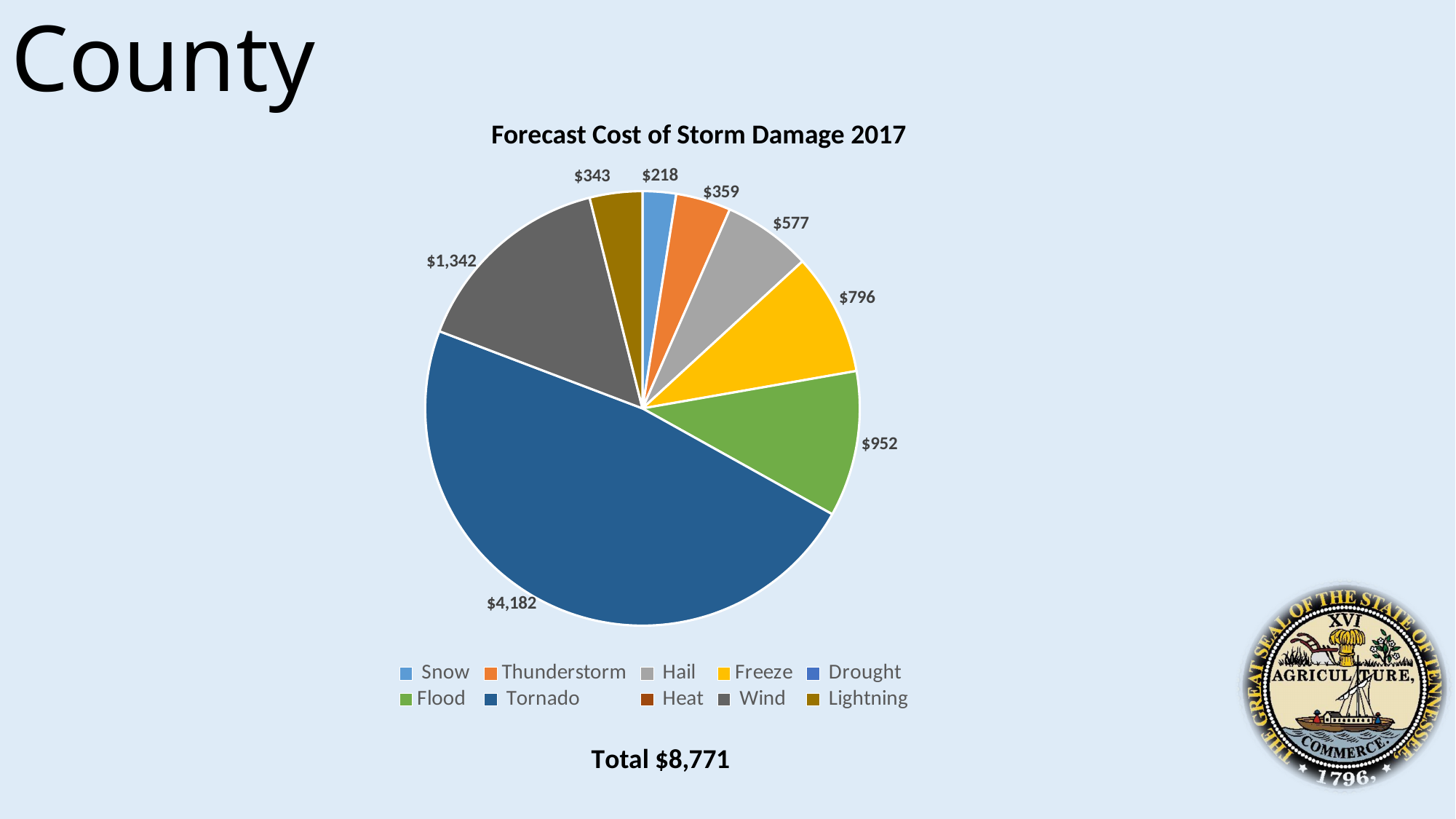
What is the title of the chart? Forecast Cost of Storm Damage 2017 What is the value shown for Snow? $218 What kind of chart is shown on the slide? Pie chart What is the forecast cost of storm damage for Tornado? $4,182 Which category has the smallest printed value on the pie? Snow What is the value shown for Wind? $1,342 What is the value shown for Lightning? $343 How many categories are listed in the legend? 10 What is the difference between the Wind value and the Flood value? $390 What is the difference between the Tornado value and the Wind value? $2,840 Which category has the largest slice of the pie? Tornado Which is larger, the value for Freeze or the value for Hail? Freeze